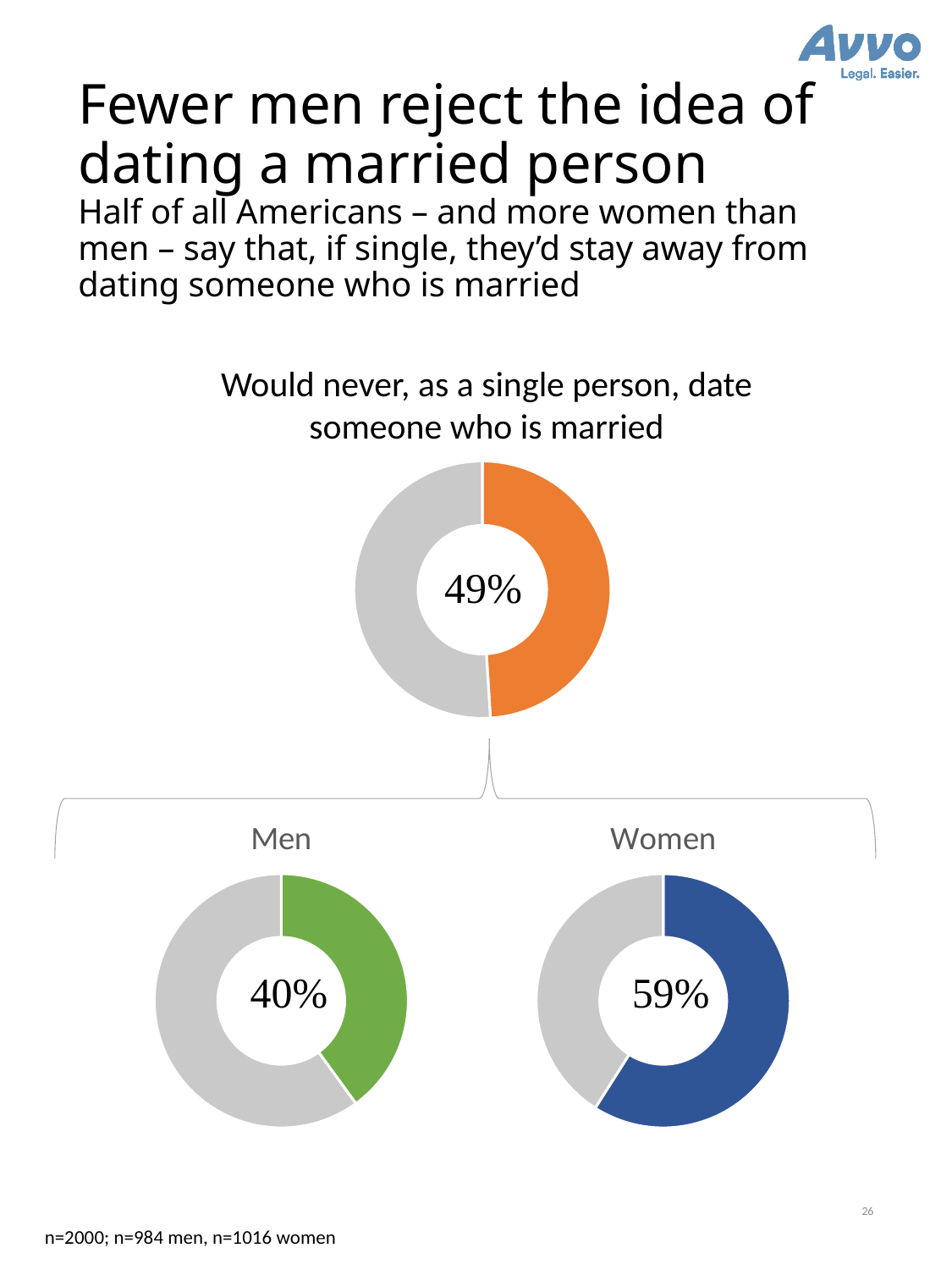
What is the title of the top donut chart? Would never, as a single person, date someone who is married What is the difference between the percentage on the Women donut chart and the percentage on the Men donut chart? 19 percentage points On the Women donut chart, what percentage of women would never, as a single person, date someone who is married? 59% How many donut charts are shown on the slide? 3 What is the difference between the percentage on the top overall donut chart and the percentage on the Men donut chart? 9 percentage points On the top donut chart titled 'Would never, as a single person, date someone who is married', what percentage is shown? 49% Comparing the Men and Women donut charts, which group has the lower percentage? Men What is the difference between the percentage on the Women donut chart and the percentage on the top overall donut chart? 10 percentage points What kind of chart is used to show the percentages on this slide? Donut (pie) chart What colour is the highlighted segment on the Women donut chart? Blue On the Men donut chart, what percentage of men would never, as a single person, date someone who is married? 40% Comparing the Men and Women donut charts, which group has the higher percentage? Women